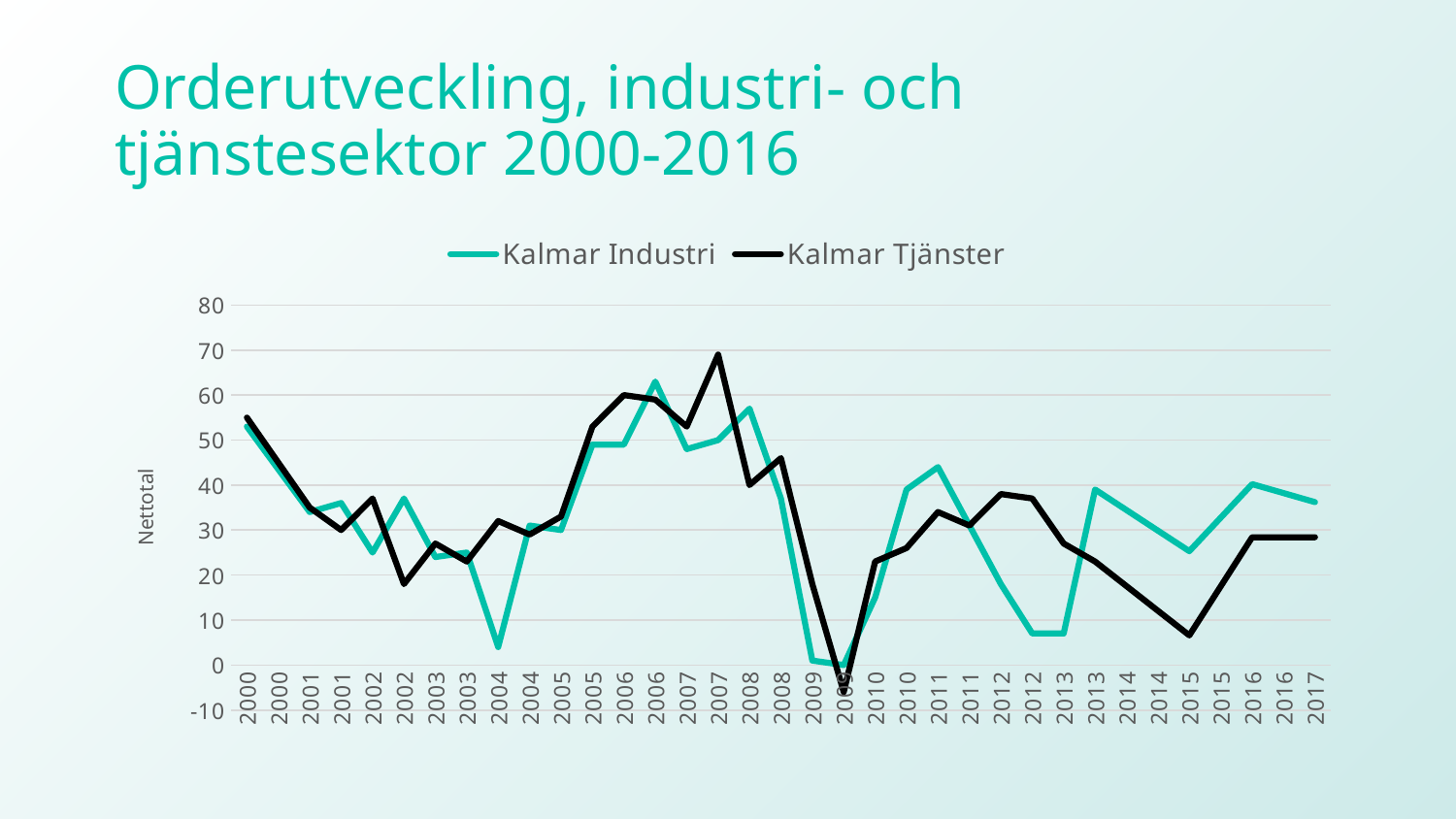
Is the value for Kalmar Tjänster at the first 2002 point greater or less than 20? greater What is the title of the chart on the slide? Orderutveckling, industri- och tjänstesektor 2000-2016 Is the value for Kalmar Industri at the first 2004 point greater or less than 10? less Do the values for Kalmar Industri rise or fall from the first 2004 point to the first 2006 point? rise What kind of chart is shown on the slide? line chart Which series reaches the highest value anywhere on the chart? Kalmar Tjänster Is the peak value of Kalmar Tjänster in 2007 greater or less than 60? greater What is the label on the vertical axis? Nettotal At the first 2011 point, which series has the larger value, Kalmar Industri or Kalmar Tjänster? Kalmar Industri How many series does the legend list? 2 Which series reaches the lowest value anywhere on the chart? Kalmar Tjänster